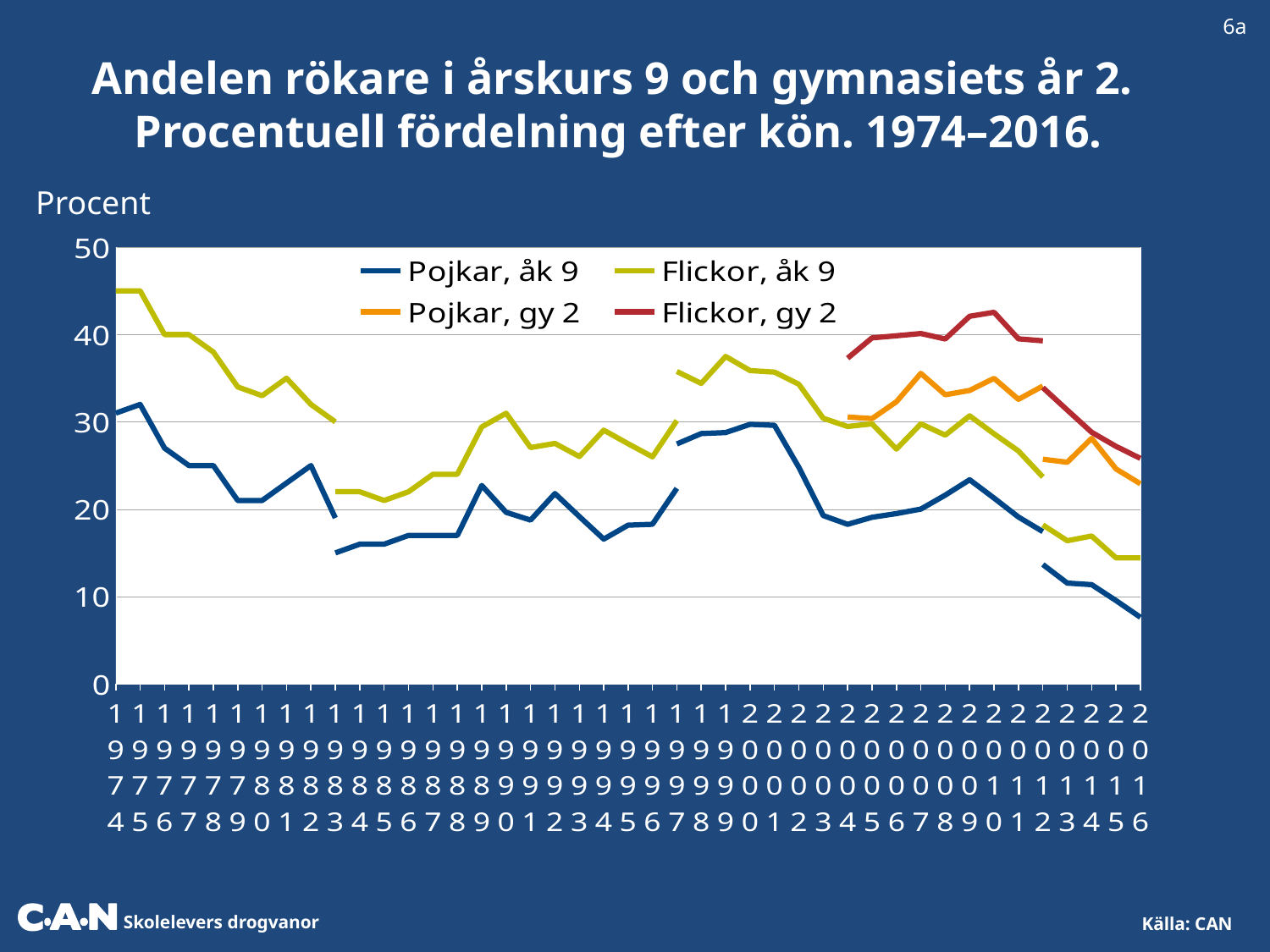
Which series has the highest value in 2010? Flickor, gy 2 What label is shown above the vertical axis of the chart? Procent Is the value for Flickor, åk 9 in 1974 greater or less than 40? greater Is the value for Pojkar, åk 9 in 2016 greater or less than 10? less In 2016, which is larger: the value for Flickor, åk 9 or the value for Pojkar, åk 9? Flickor, åk 9 How many series does the legend list? 4 What is the title of the chart? Andelen rökare i årskurs 9 och gymnasiets år 2. Procentuell fördelning efter kön. 1974–2016. Which series has the highest value in 1974? Flickor, åk 9 Do the values for Pojkar, åk 9 rise or fall from 2010 to 2016? fall Is the value for Pojkar, åk 9 in 1984 greater or less than 20? less What kind of chart is shown on the slide? line chart